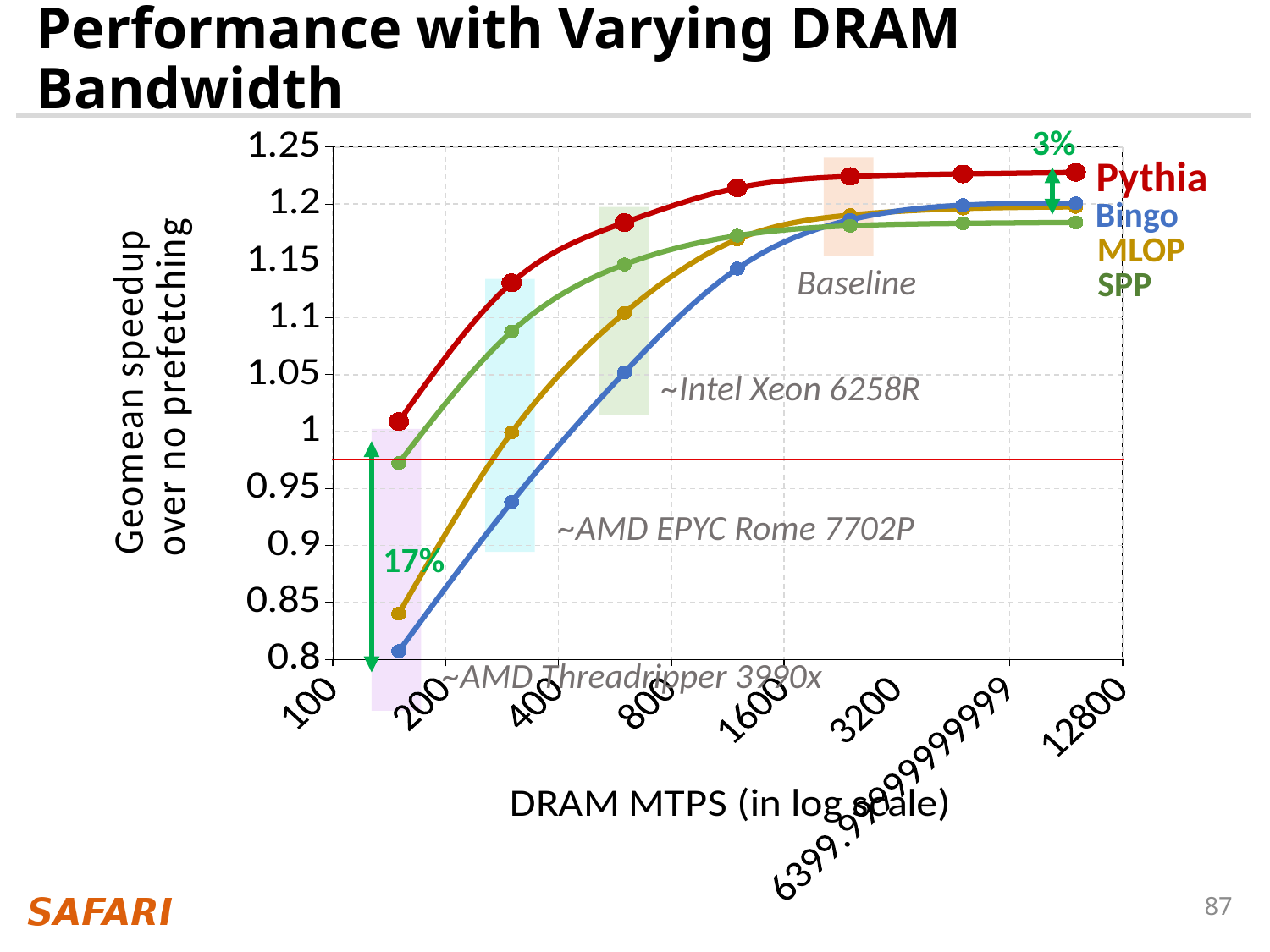
Which series has the highest speedup at the lowest DRAM bandwidth plotted? Pythia Is the speedup of Pythia at the highest DRAM bandwidth plotted greater or less than 1.2? greater Is the speedup of Bingo at the lowest DRAM bandwidth plotted greater or less than 0.85? less How many data points does the Pythia series have? 7 Which series has the highest speedup at the highest DRAM bandwidth plotted? Pythia Does the Bingo series rise or fall as DRAM MTPS increases? rise How many series does the chart show? 4 At the lowest DRAM bandwidth plotted, which is larger: the speedup of Pythia or of MLOP? Pythia What is the label of the y axis? Geomean speedup over no prefetching Which series has the lowest speedup at the lowest DRAM bandwidth plotted? Bingo Which series are plotted on the chart? Pythia, Bingo, MLOP, SPP What kind of chart is shown on the slide? line chart